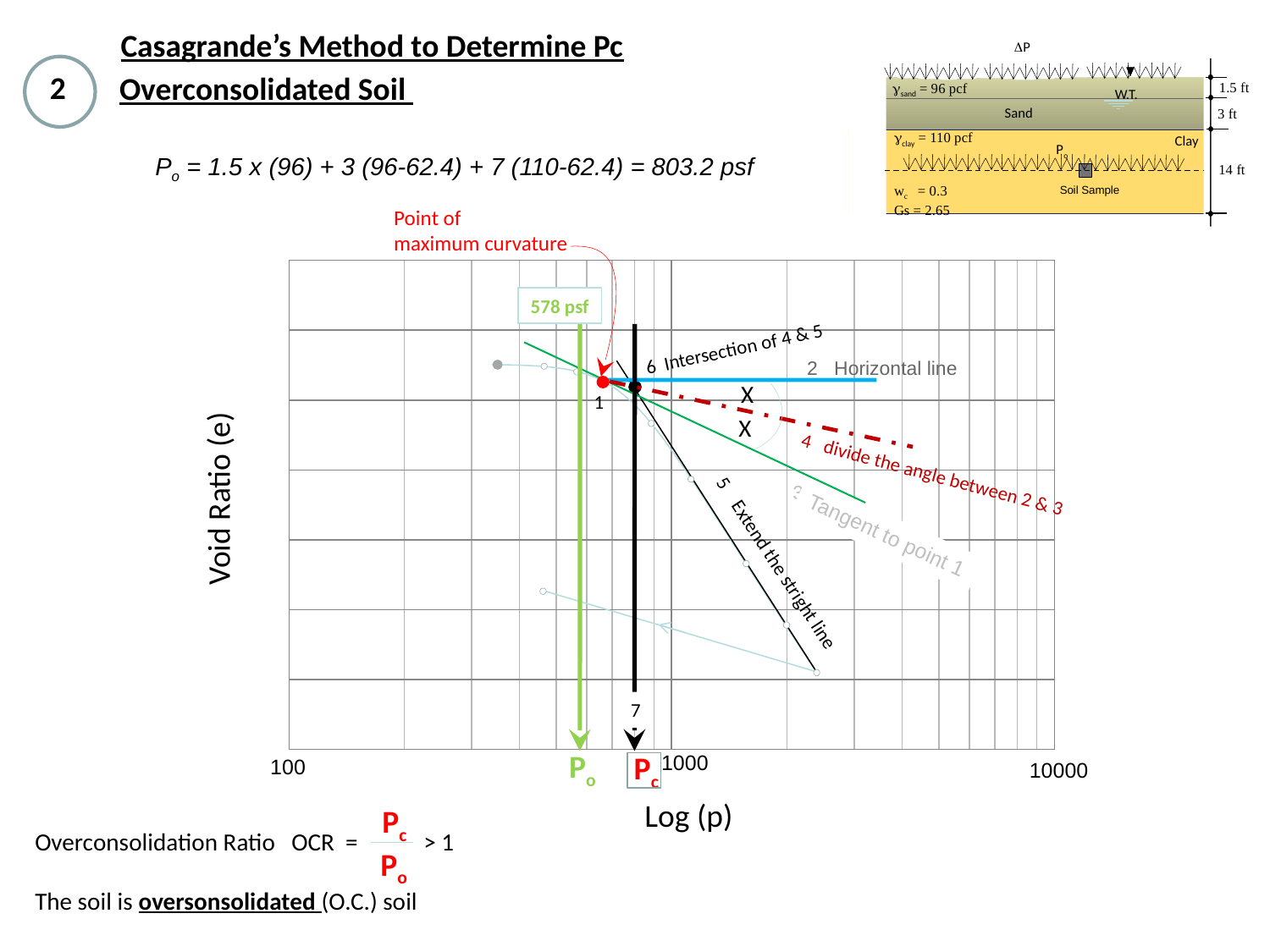
What kind of chart is shown on the slide? line chart What is the label of the x axis of the chart? Log (p) Does the void ratio rise or fall as Log (p) increases along the loading curve? fall How many tick labels are printed on the x axis of the chart? 3 What is the largest value printed on the x axis of the chart? 10000 What is the label of the y axis of the chart? Void Ratio (e) Which is larger on the chart, Pc or Po? Pc Is the value of Po on the chart greater or less than 1000? less Is the value of Pc on the chart greater or less than 10000? less What is the smallest value printed on the x axis of the chart? 100 Is the value of Po on the chart greater or less than 100? greater